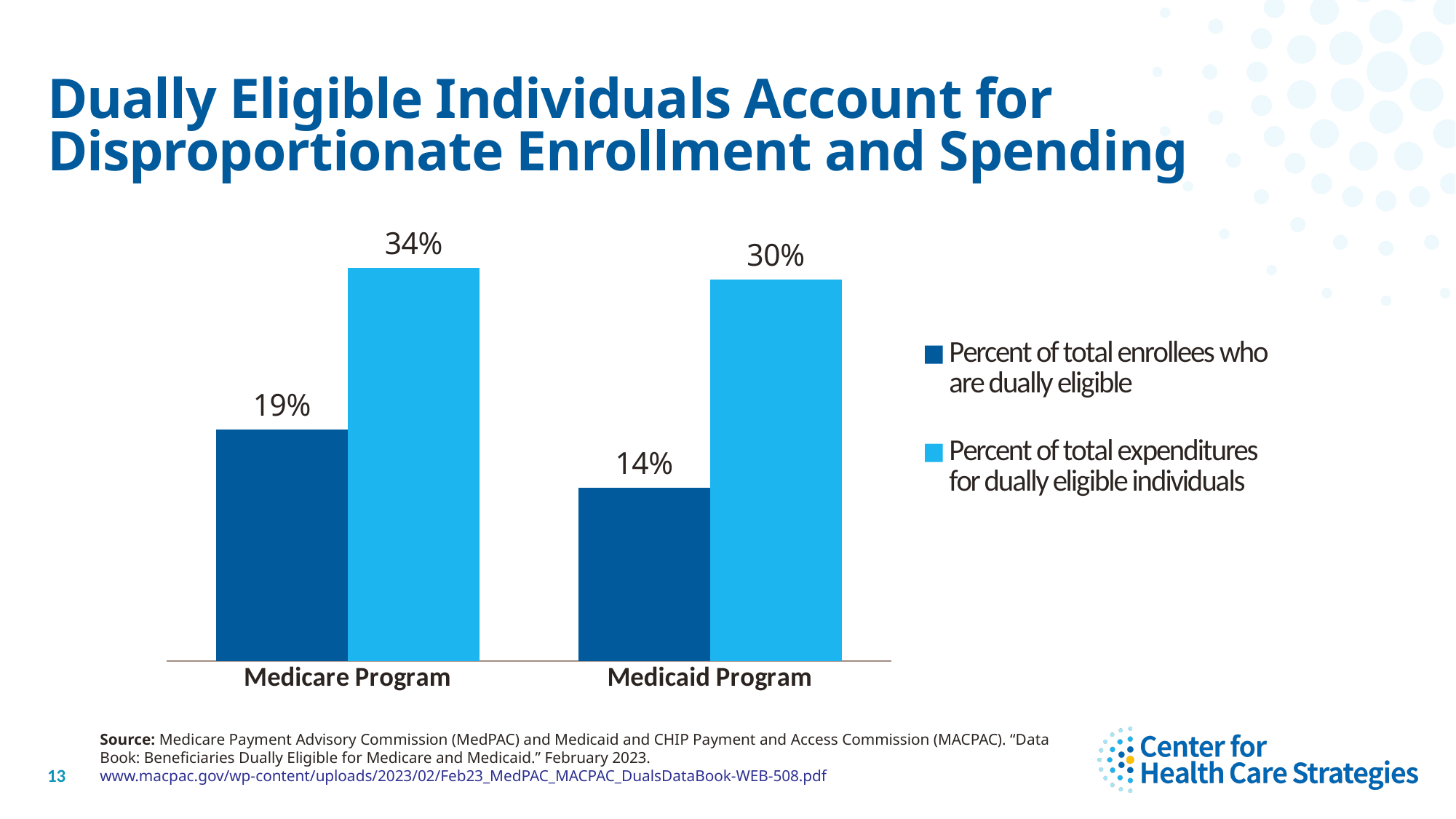
Which program has the lower percent of total enrollees who are dually eligible? Medicaid Program What percent of total expenditures in the Medicaid Program are for dually eligible individuals? 30% How many series does the chart legend list? 2 What percent of total enrollees in the Medicare Program are dually eligible? 19% What is the difference between the percent of total expenditures and the percent of total enrollees for the Medicare Program? 15% What is the difference between the percent of total expenditures and the percent of total enrollees for the Medicaid Program? 16% How many programs are shown on the x axis of the chart? 2 What kind of chart is shown on the slide? Bar chart Which program has the higher percent of total expenditures for dually eligible individuals? Medicare Program What percent of total enrollees in the Medicaid Program are dually eligible? 14% Is the percent of total enrollees who are dually eligible larger for the Medicare Program or the Medicaid Program? Medicare Program What percent of total expenditures in the Medicare Program are for dually eligible individuals? 34%